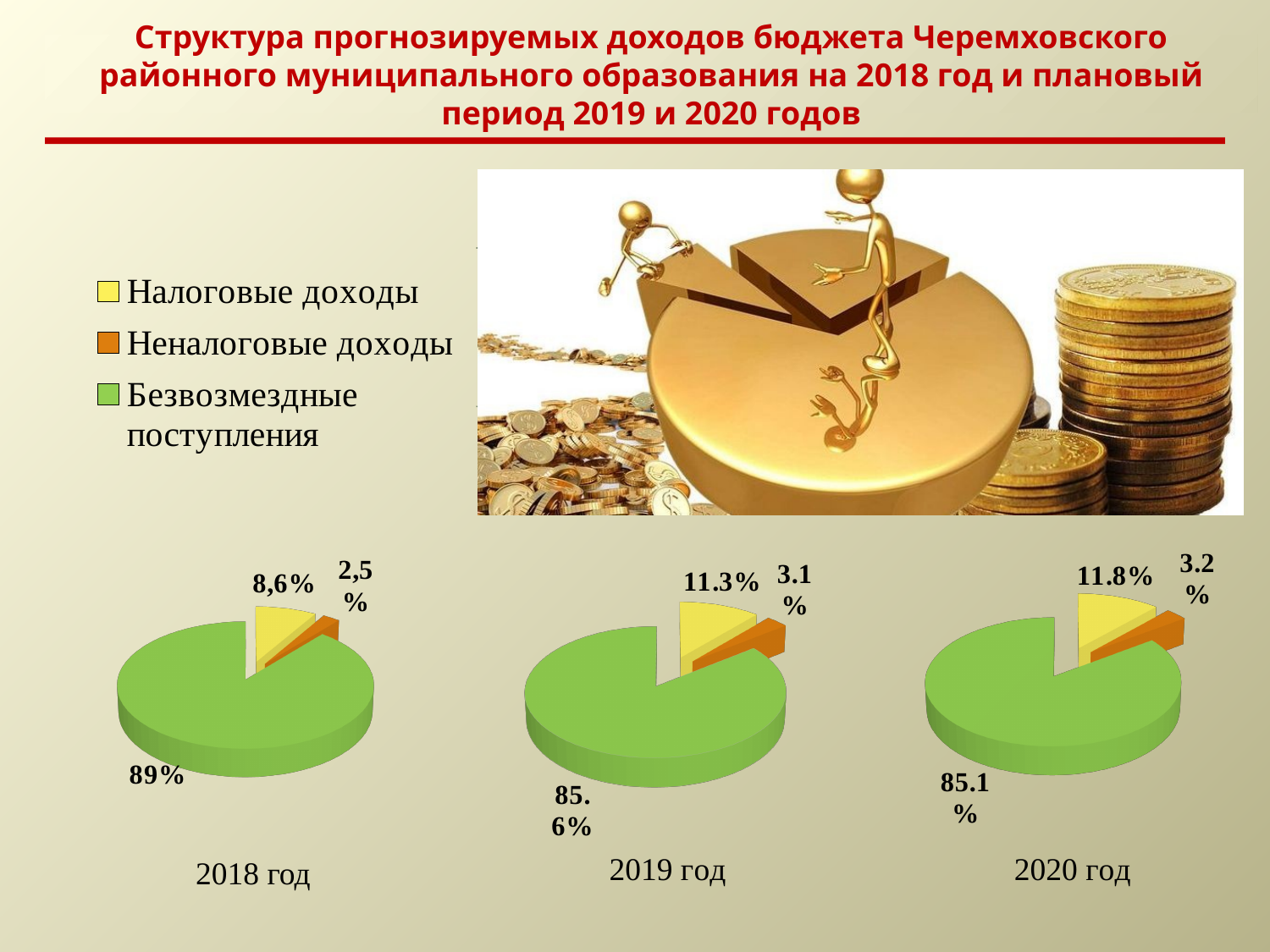
In the pie chart labelled 2018 год, what share is shown for Налоговые доходы (yellow slice)? 8,6% In the pie chart labelled 2019 год, which category has the smallest share? Неналоговые доходы Which is larger: the share of Налоговые доходы in the 2018 год chart or in the 2020 год chart? 2020 год In the pie chart labelled 2020 год, what share is shown for Неналоговые доходы (orange slice)? 3.2% In the pie chart labelled 2019 год, what share is shown for Безвозмездные поступления (green slice)? 85.6% In the pie chart labelled 2018 год, what share is shown for Неналоговые доходы (orange slice)? 2,5% How many pie charts are shown on the slide? 3 In the pie chart labelled 2018 год, what share is shown for Безвозмездные поступления (green slice)? 89% In the pie chart labelled 2019 год, what share is shown for Налоговые доходы (yellow slice)? 11.3% In the pie chart labelled 2020 год, which category has the largest share? Безвозмездные поступления How many categories does the legend list? 3 In the pie chart labelled 2020 год, what share is shown for Безвозмездные поступления (green slice)? 85.1%